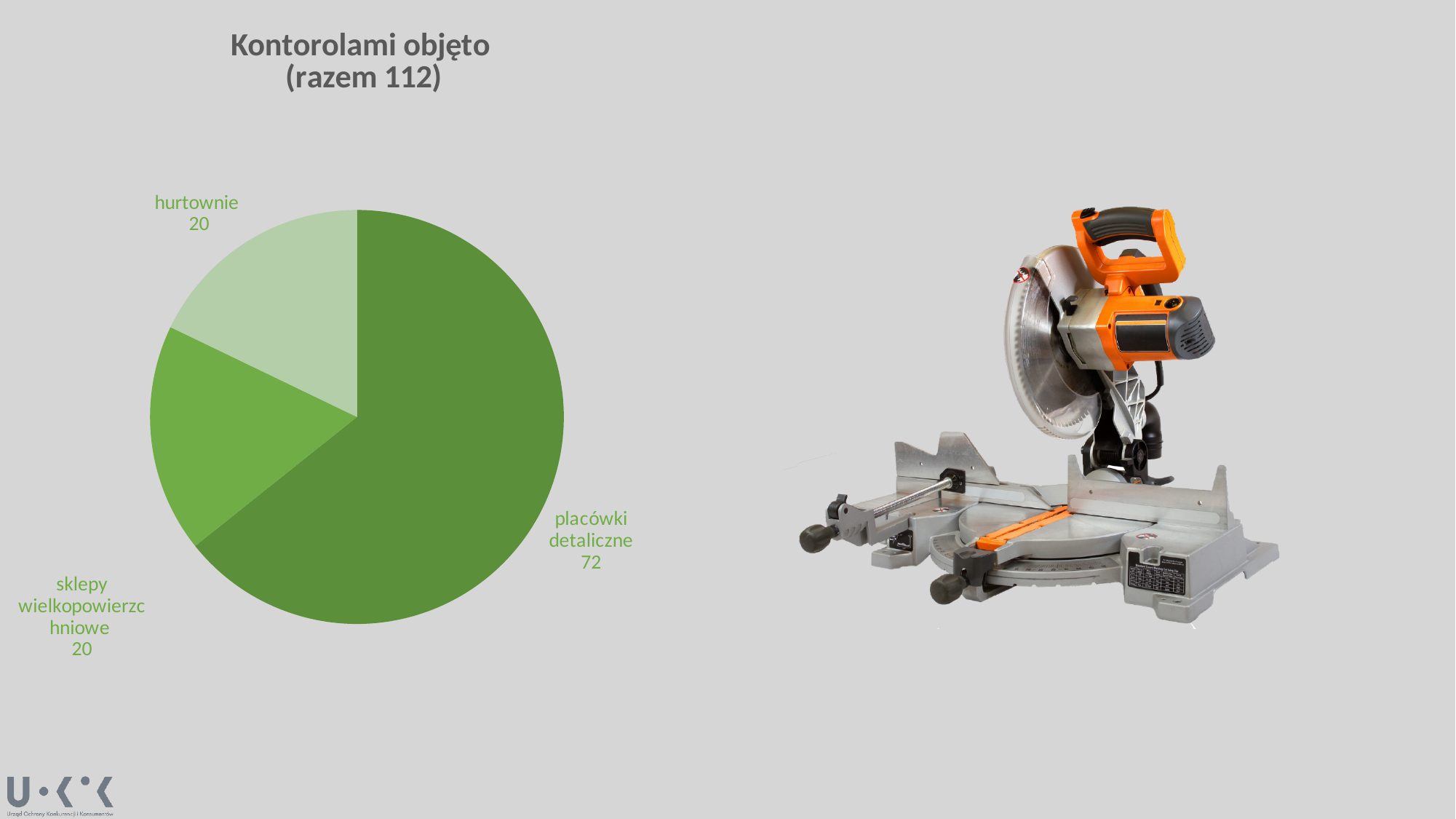
Which is larger, placówki detaliczne or sklepy wielkopowierzchniowe? placówki detaliczne What is the difference between placówki detaliczne and hurtownie? 52 What is the total of all slices in the pie chart? 112 What is the value for hurtownie? 20 How many slices does the pie chart have? 3 What type of chart is shown on the slide? pie chart Is the value for placówki detaliczne greater or less than 50? greater What is the value for sklepy wielkopowierzchniowe? 20 What is the value for placówki detaliczne? 72 Which category has the largest slice? placówki detaliczne What is the title of the chart? Kontorolami objęto (razem 112)